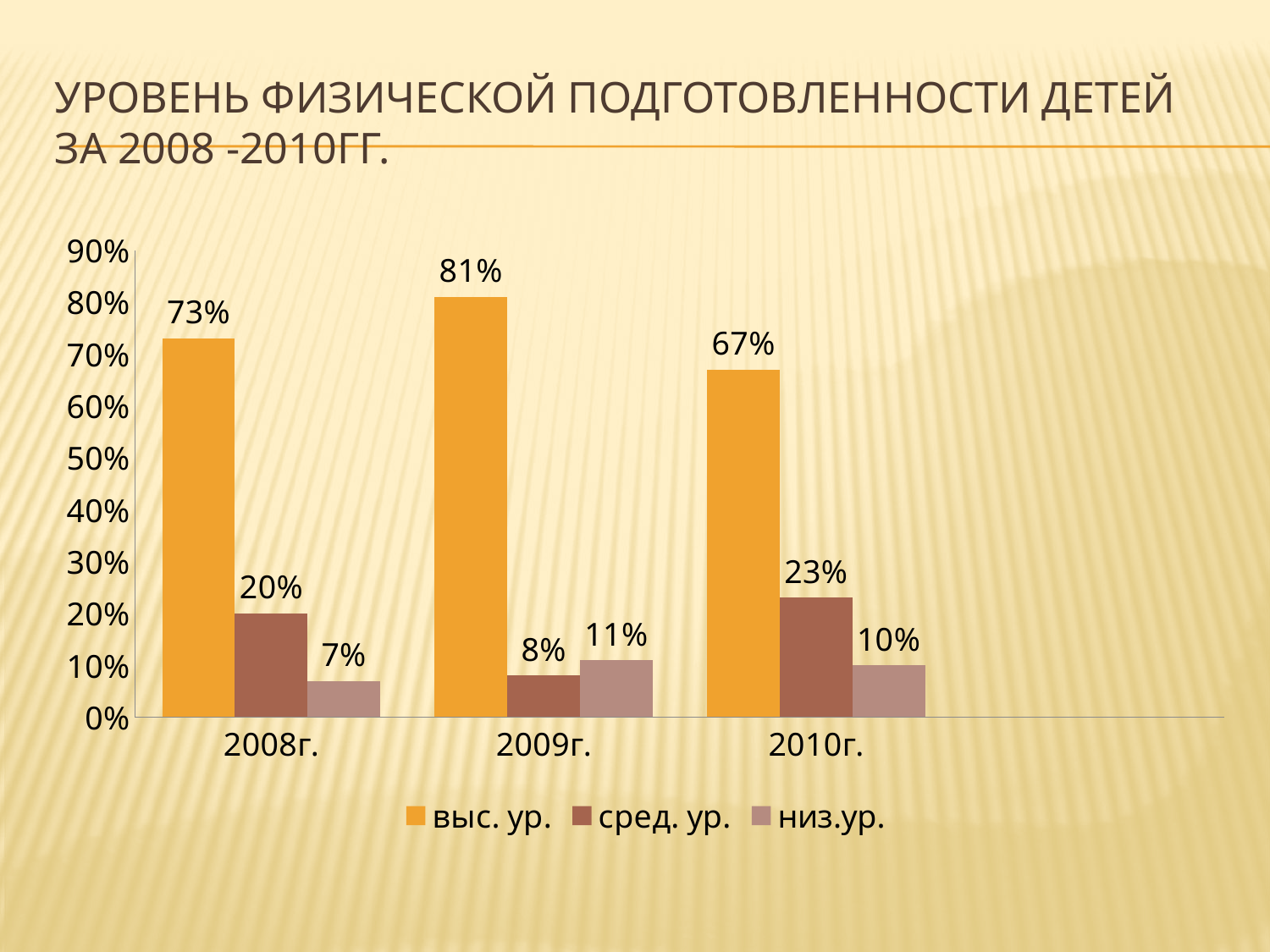
What is the value for низ.ур. in 2008г.? 7% What is the value for сред. ур. in 2010г.? 23% How many series does the legend list? 3 What is the difference between the выс. ур. values for 2009г. and 2010г.? 14% In which year is the value for сред. ур. lowest? 2009г. What is the value for выс. ур. in 2009г.? 81% What kind of chart is shown on the slide? bar chart Does the value for сред. ур. rise or fall from 2009г. to 2010г.? rise In which year is the value for выс. ур. highest? 2009г. Is the value for выс. ур. in 2008г. greater or less than 70%? greater Which is larger: низ.ур. in 2009г. or низ.ур. in 2010г.? низ.ур. in 2009г. How many years are shown on the x axis? 3